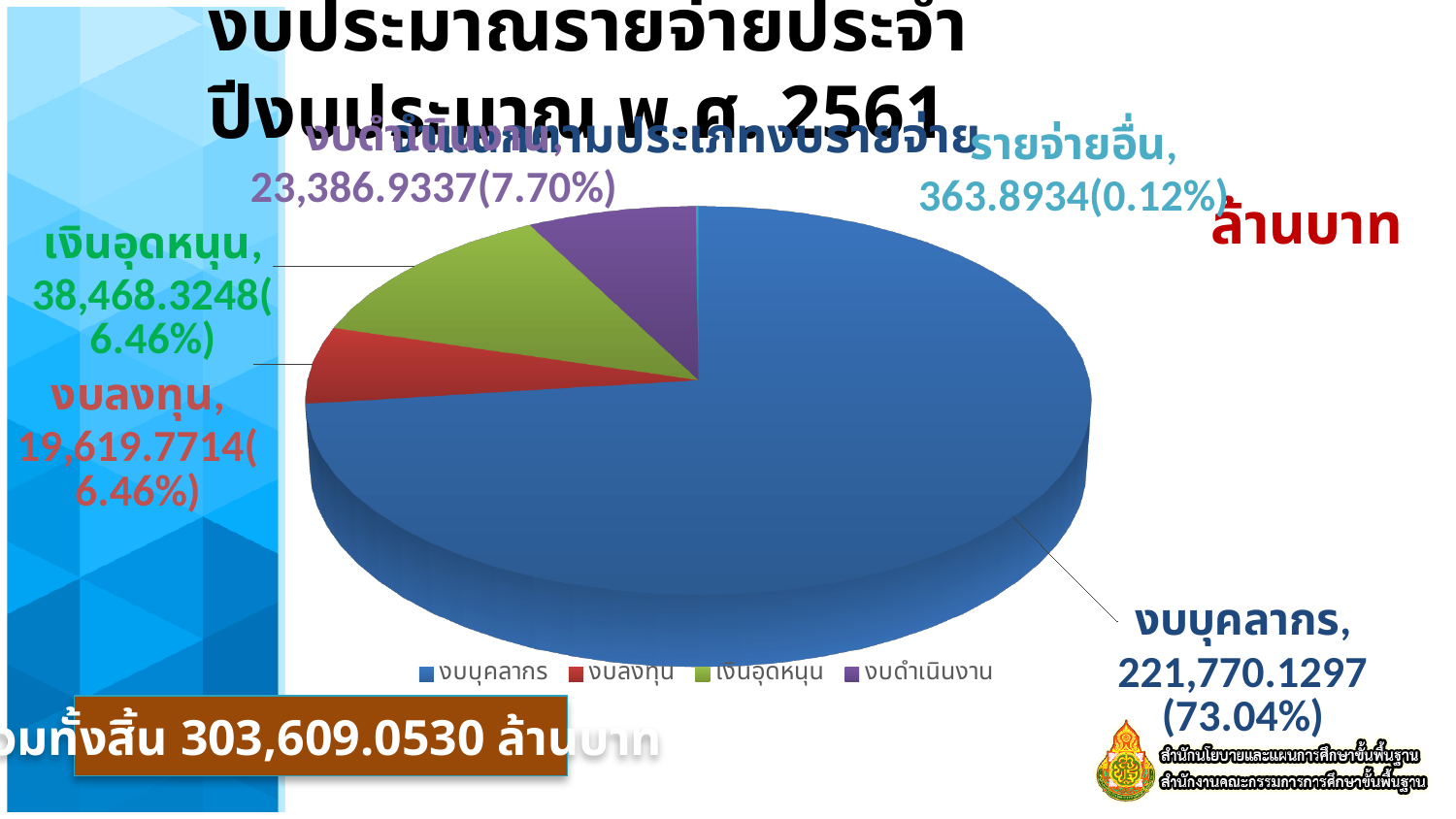
What is the value shown for งบดำเนินงาน? 23,386.9337 What percentage share of the pie does งบบุคลากร have? 73.04% What is the value shown for เงินอุดหนุน? 38,468.3248 What kind of chart is shown on the slide? pie chart What is the value shown for งบบุคลากร? 221,770.1297 Which category has the largest slice of the pie? งบบุคลากร What is the difference between the values for งบบุคลากร and งบลงทุน? 202,150.3583 What is the value shown for รายจ่ายอื่น? 363.8934 Which is larger, เงินอุดหนุน or งบดำเนินงาน? เงินอุดหนุน Which category has the smallest slice of the pie? รายจ่ายอื่น How many slices does the pie chart have? 5 How many entries does the legend list? 4